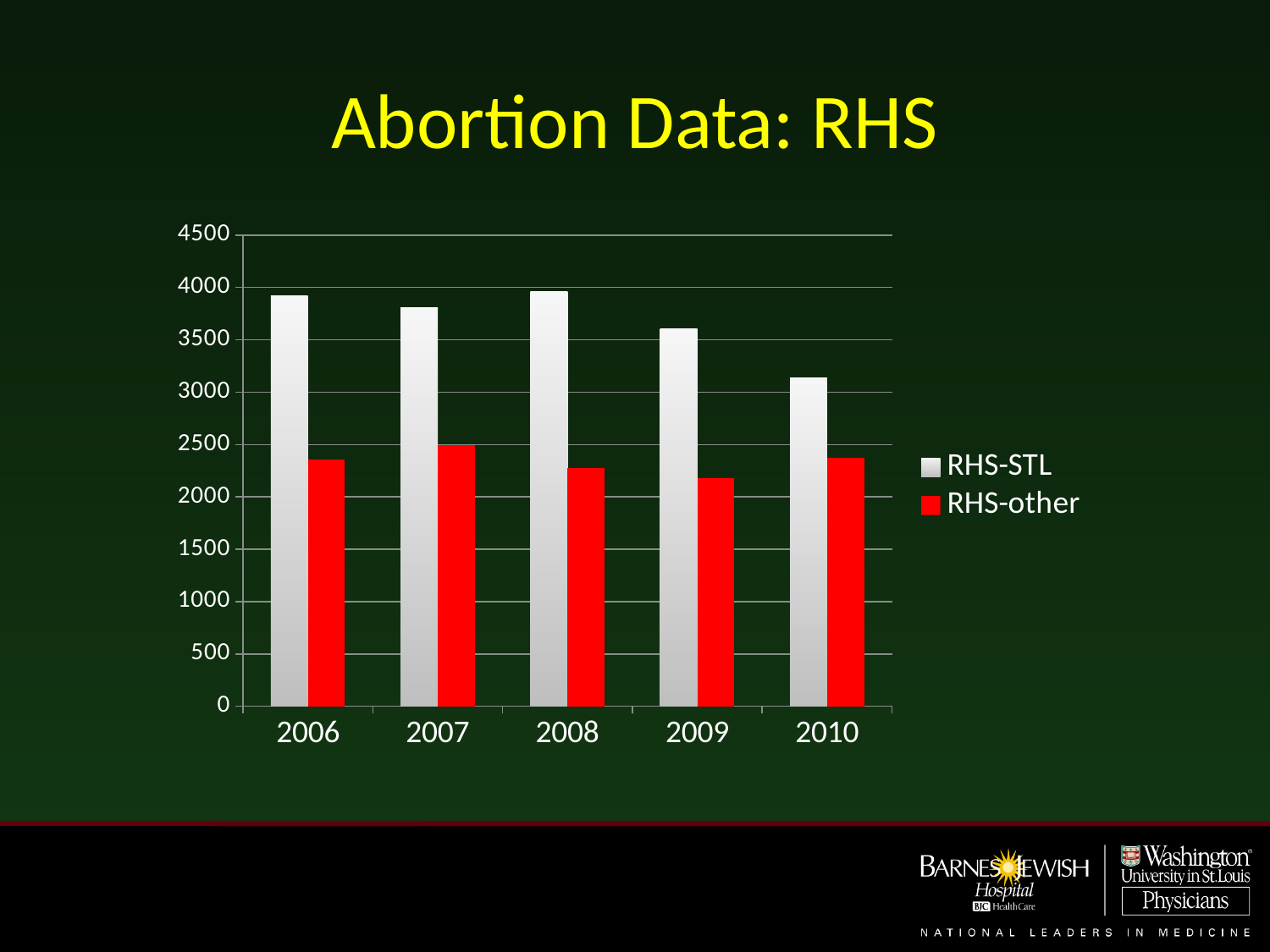
Is the RHS-STL value for 2009 greater or less than 4000? less In 2006, which is larger, RHS-STL or RHS-other? RHS-STL In which year is the RHS-other value highest? 2007 What is the title of the chart on the slide? Abortion Data: RHS Is the RHS-other value for 2009 greater or less than 2500? less In which year is the RHS-STL value lowest? 2010 What kind of chart is shown on the slide? bar chart How many series does the legend list? 2 Is the RHS-STL value for 2010 greater or less than 3000? greater Do the RHS-STL values rise or fall from 2008 to 2010? fall How many years are shown on the x axis? 5 Which series is shown in red? RHS-other